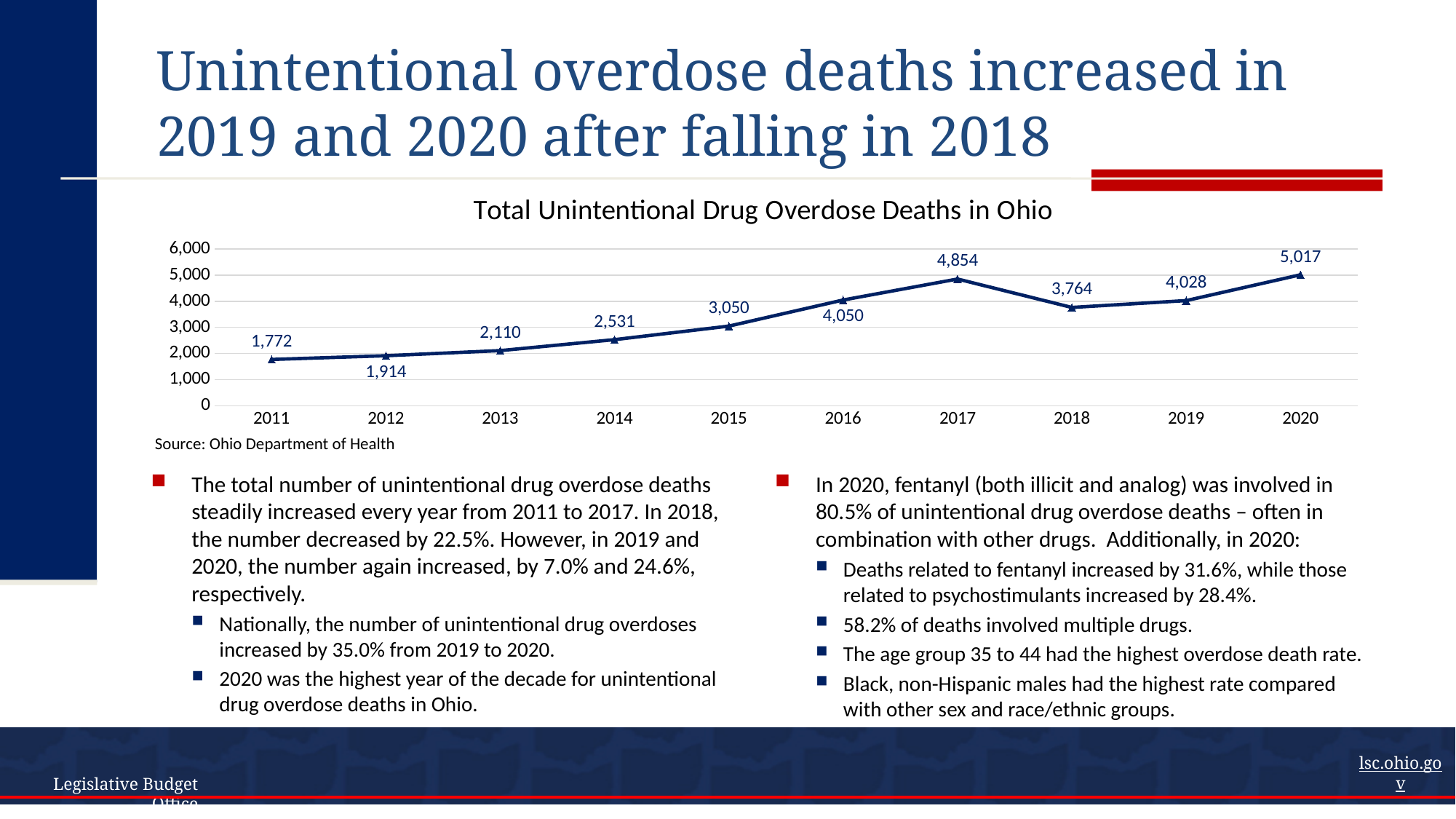
How many years are plotted in the chart? 10 What is the value for 2011 in the chart? 1,772 What is the difference between the values for 2020 and 2019? 989 Which year has the highest value in the chart? 2020 Is the value for 2015 greater or less than 4,000? less Which is larger, the value for 2016 or the value for 2018? 2016 What is the difference between the values for 2017 and 2018? 1,090 What is the title of the chart? Total Unintentional Drug Overdose Deaths in Ohio What kind of chart is shown on the slide? line chart What is the value for 2018 in the chart? 3,764 What is the value for 2017 in the chart? 4,854 Which year has the lowest value in the chart? 2011